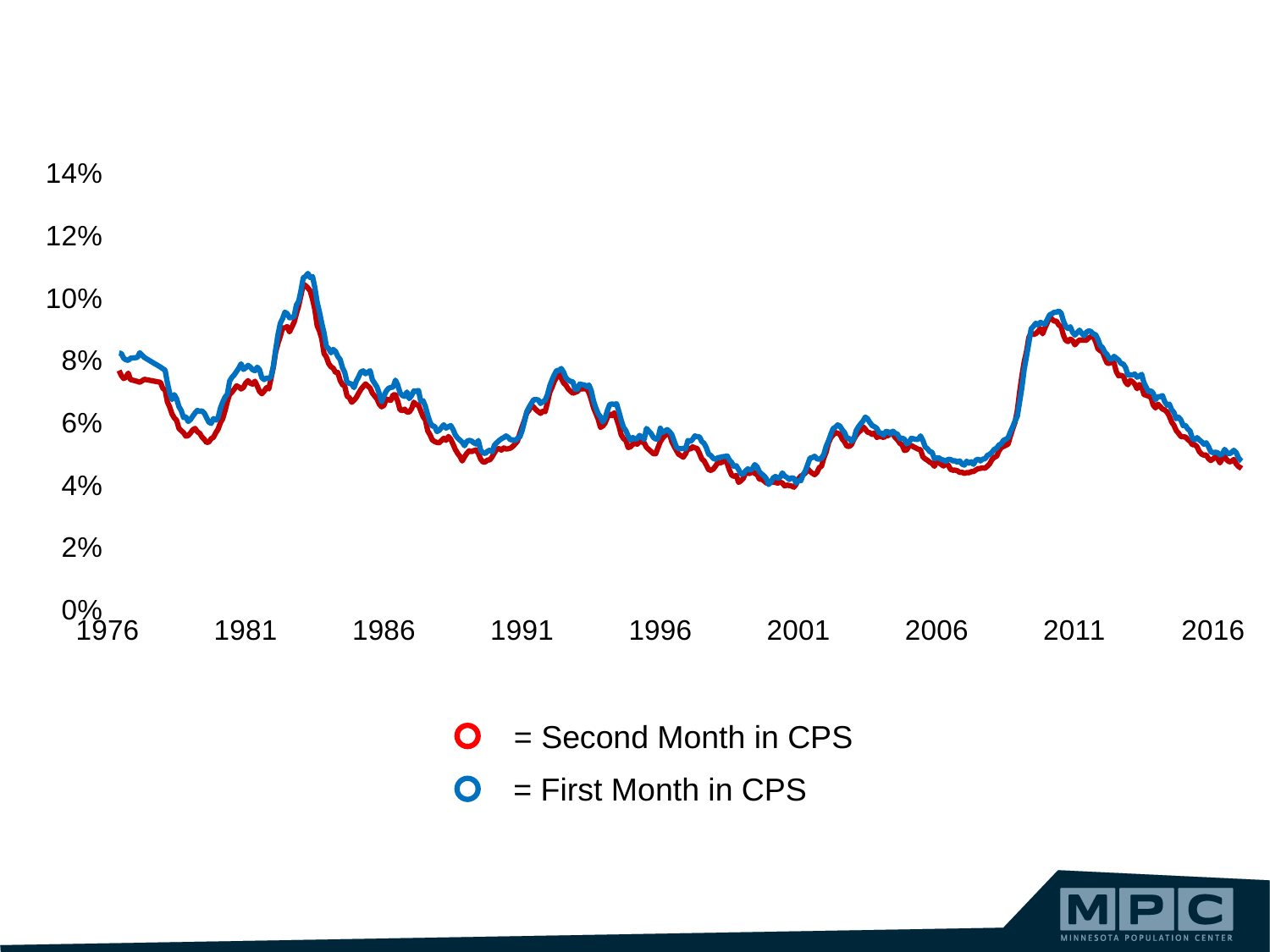
Is the value of the First Month in CPS series at 1976 greater or less than 6%? greater Which series is drawn in blue? First Month in CPS Do the values of both series rise or fall between 2011 and 2016? fall Is the highest peak of the chart, between 1981 and 1986, higher or lower than the peak between 2006 and 2011? higher Is the value of the Second Month in CPS series around 2001 greater or less than 6%? less What kind of chart is shown on the slide? line chart Is the value of the First Month in CPS series around 2011 greater or less than 8%? greater How many series does the legend list? 2 Which series is drawn in red? Second Month in CPS At 1976, which series has the higher value, First Month in CPS or Second Month in CPS? First Month in CPS